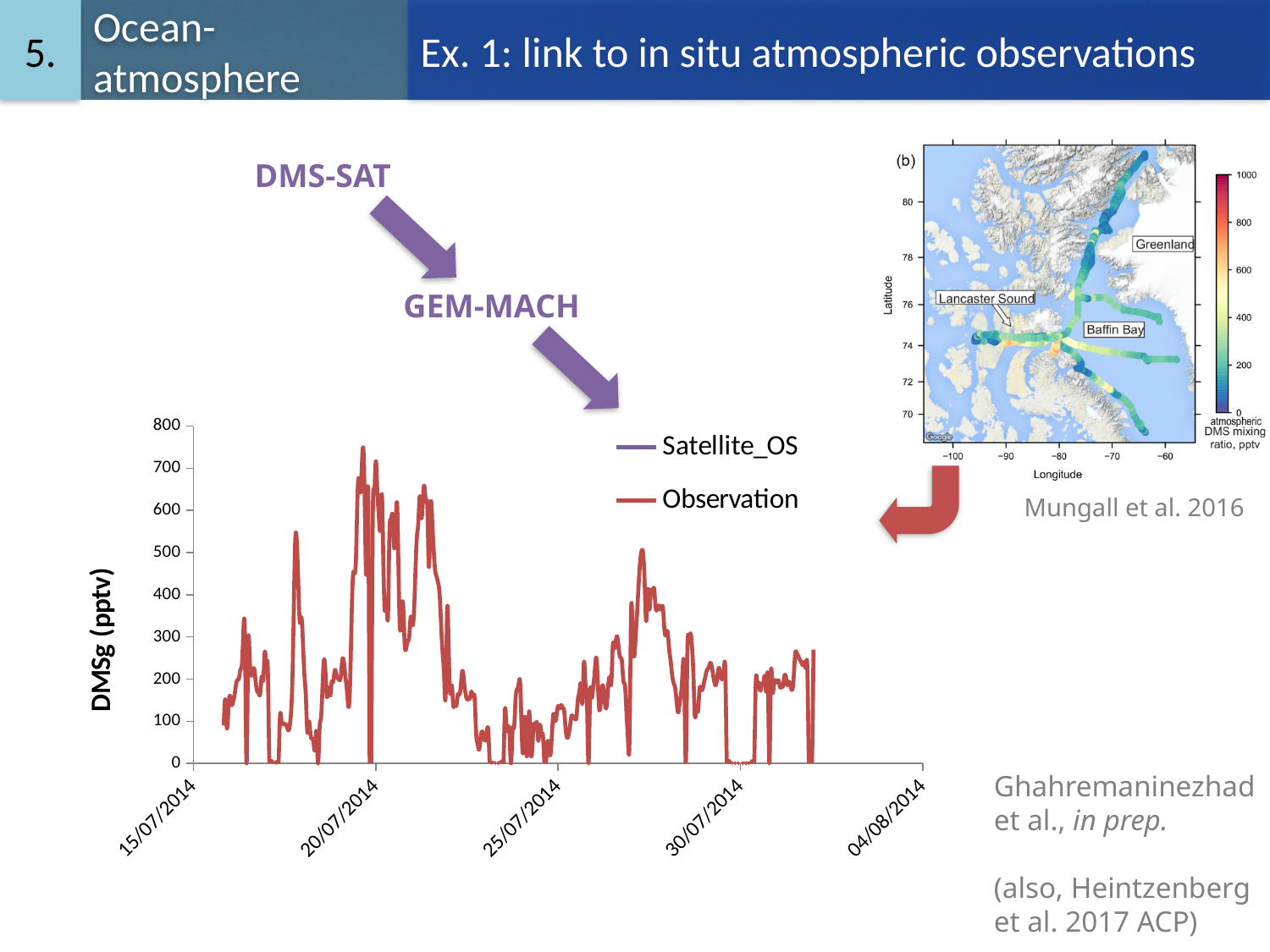
In the DMSg (pptv) chart, which Observation peak is larger: the one near 20/07/2014 or the one between 25/07/2014 and 30/07/2014? the one near 20/07/2014 What are the two series named in the legend of the DMSg (pptv) chart? Satellite_OS and Observation What kind of chart is the DMSg (pptv) chart on the slide? line chart How many series does the legend of the DMSg (pptv) chart list? 2 How many date tick labels are shown on the x-axis of the DMSg (pptv) chart? 5 What is the highest value shown on the y-axis of the DMSg (pptv) chart? 800 What is the y-axis label of the line chart on the slide? DMSg (pptv) In the DMSg (pptv) chart, is the highest peak of the Observation series (near 20/07/2014) greater or less than 700? greater In the DMSg (pptv) chart, is the highest peak of the Observation series greater or less than 800? less What is the first date label on the x-axis of the DMSg (pptv) chart? 15/07/2014 What is the last date label on the x-axis of the DMSg (pptv) chart? 04/08/2014 In the DMSg (pptv) chart, are the Observation values at 25/07/2014 greater or less than 300? less